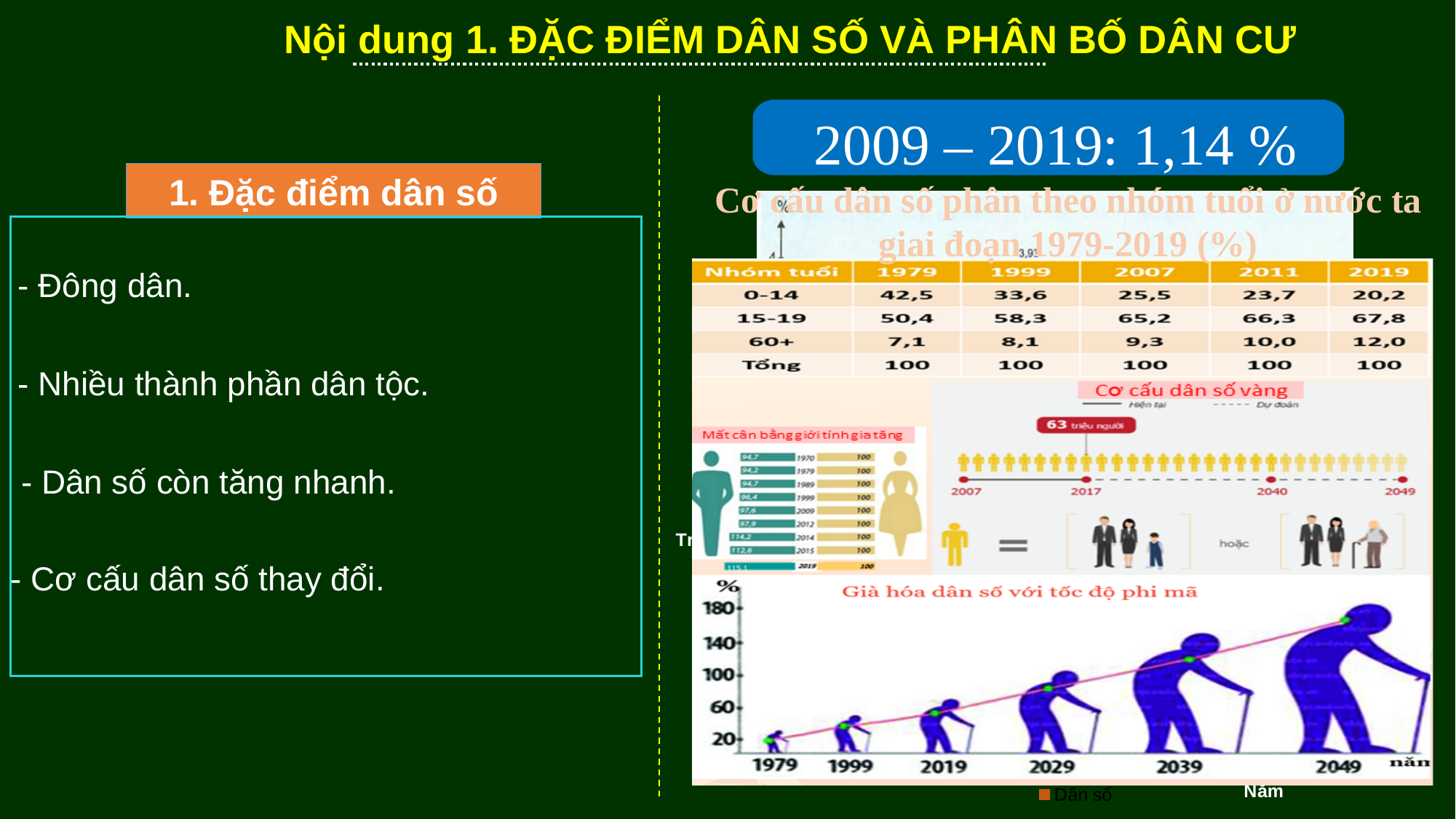
In the table 'Cơ cấu dân số phân theo nhóm tuổi ở nước ta giai đoạn 1979-2019 (%)', what is the value for the 0-14 group in 1979? 42,5 In the chart 'Già hóa dân số với tốc độ phi mã', is the value for 2049 greater or less than 140? greater In the table 'Cơ cấu dân số phân theo nhóm tuổi ở nước ta giai đoạn 1979-2019 (%)', what is the value for the 60+ group in 2019? 12,0 In the table 'Cơ cấu dân số phân theo nhóm tuổi ở nước ta giai đoạn 1979-2019 (%)', what is the difference between the 15-19 group values in 2019 and 1979? 17,4 In the chart 'Già hóa dân số với tốc độ phi mã', what is the highest tick shown on the y axis? 180 In the chart 'Già hóa dân số với tốc độ phi mã', which year has the highest value? 2049 In the chart 'Già hóa dân số với tốc độ phi mã', which year has the lowest value? 1979 In the chart 'Già hóa dân số với tốc độ phi mã', is the value for 2039 greater or less than 100? greater What kind of chart is 'Già hóa dân số với tốc độ phi mã'? line chart In the chart 'Già hóa dân số với tốc độ phi mã', do the values rise or fall from 1979 to 2049? rise In the chart 'Già hóa dân số với tốc độ phi mã', how many years are marked on the x axis? 6 In the chart 'Già hóa dân số với tốc độ phi mã', is the value for 1979 greater or less than 60? less